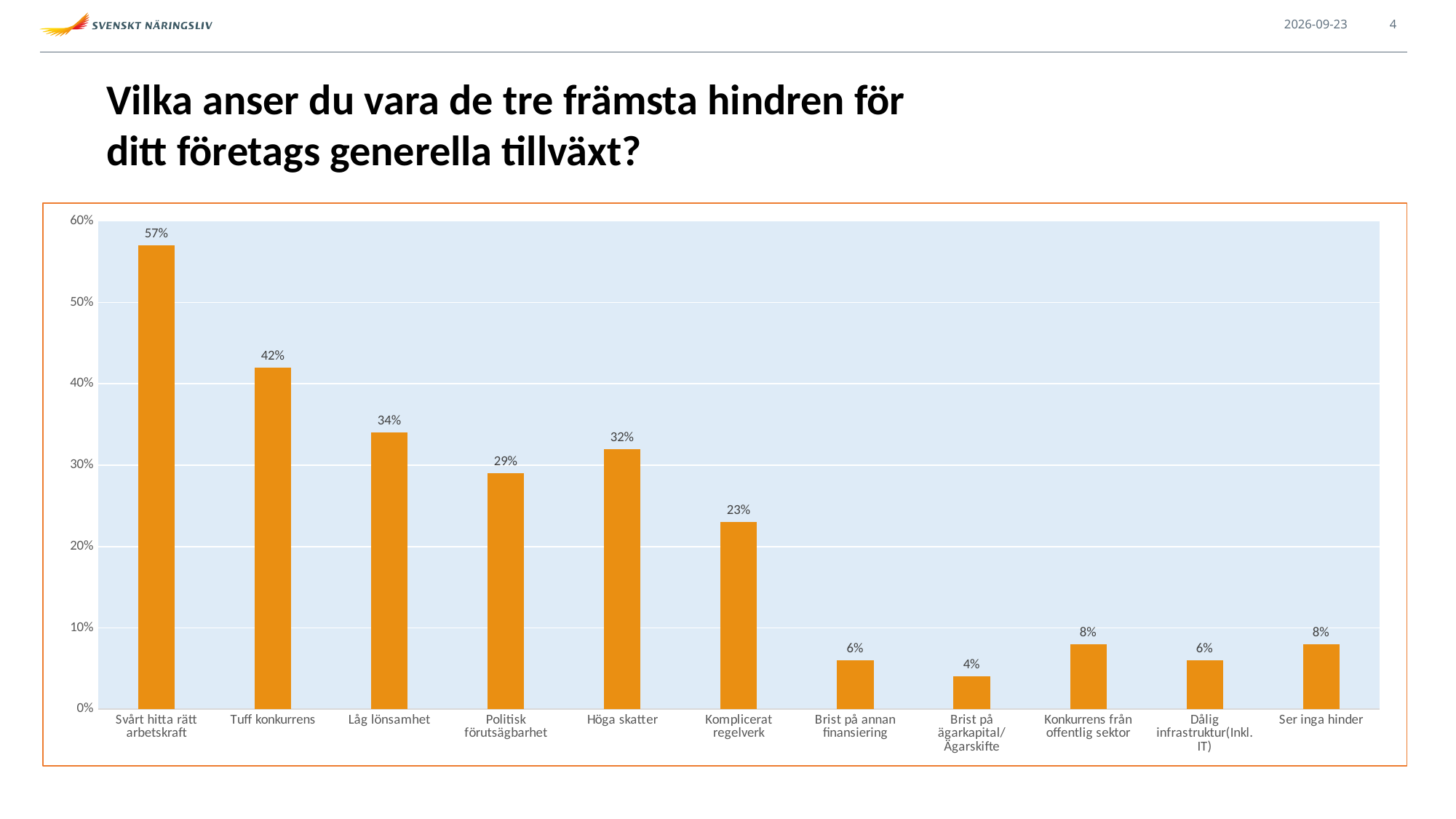
What colour are the bars in the chart? orange What is the value for Svårt hitta rätt arbetskraft? 57% Which is larger, Politisk förutsägbarhet or Höga skatter? Höga skatter What kind of chart is shown on the slide? bar chart What is the difference between Tuff konkurrens and Låg lönsamhet? 8% Which category has the lowest value? Brist på ägarkapital/Ägarskifte What is the value for Ser inga hinder? 8% Which category has the highest value? Svårt hitta rätt arbetskraft What is the value for Höga skatter? 32% What is the value for Brist på ägarkapital/Ägarskifte? 4% How many categories are shown in the chart? 11 Is the value for Komplicerat regelverk greater or less than 20%? greater